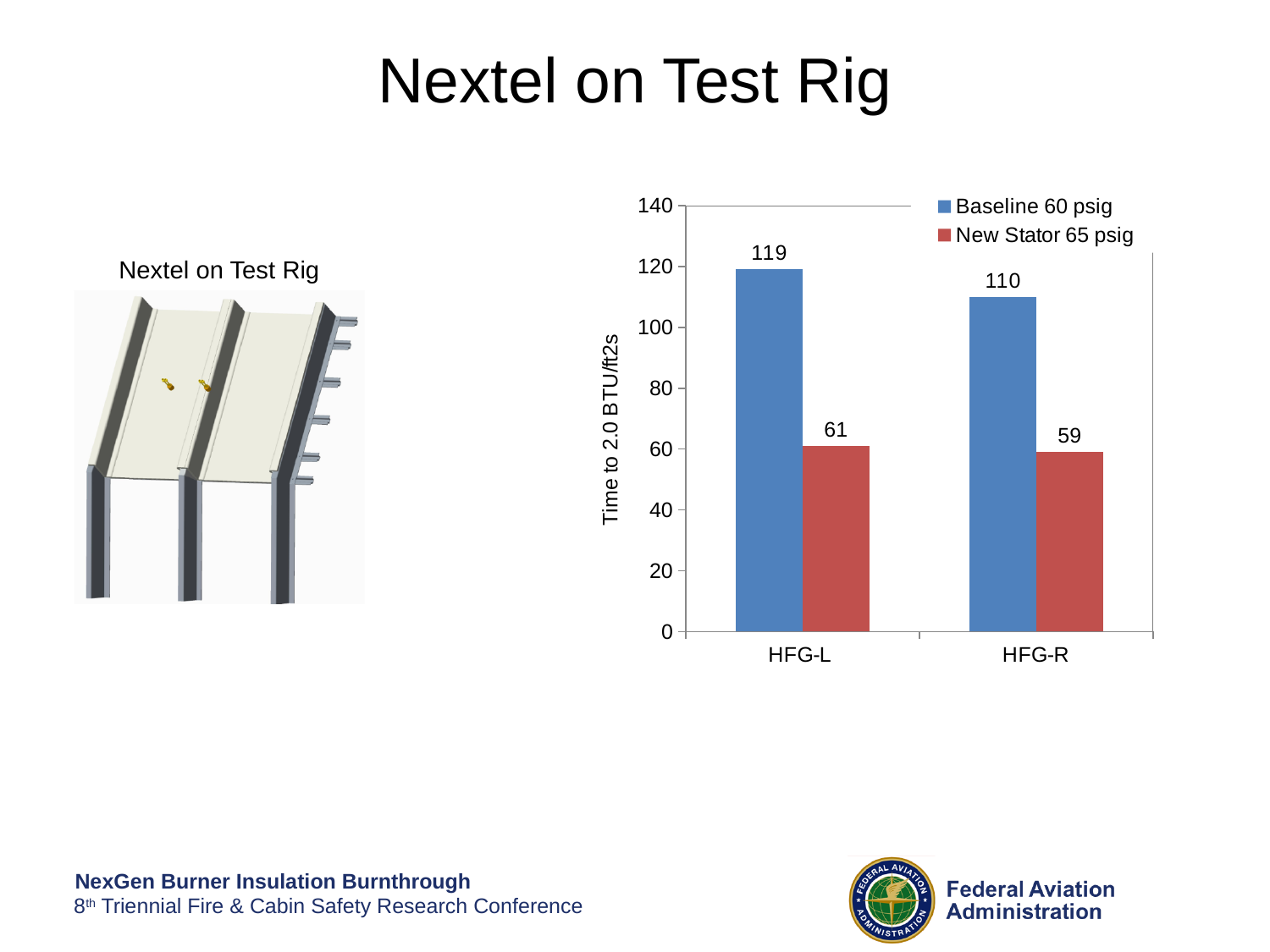
How many categories are shown on the x axis? 2 What is the Baseline 60 psig value for HFG-L? 119 Which category has the highest Baseline 60 psig value? HFG-L What is the New Stator 65 psig value for HFG-L? 61 What is the label of the y axis? Time to 2.0 BTU/ft2s What is the difference between the Baseline 60 psig values for HFG-L and HFG-R? 9 Which is larger for HFG-R: the Baseline 60 psig value or the New Stator 65 psig value? Baseline 60 psig What is the Baseline 60 psig value for HFG-R? 110 What is the difference between the Baseline 60 psig and New Stator 65 psig values for HFG-L? 58 What is the New Stator 65 psig value for HFG-R? 59 How many series does the legend list? 2 What kind of chart is shown on the slide? Bar chart